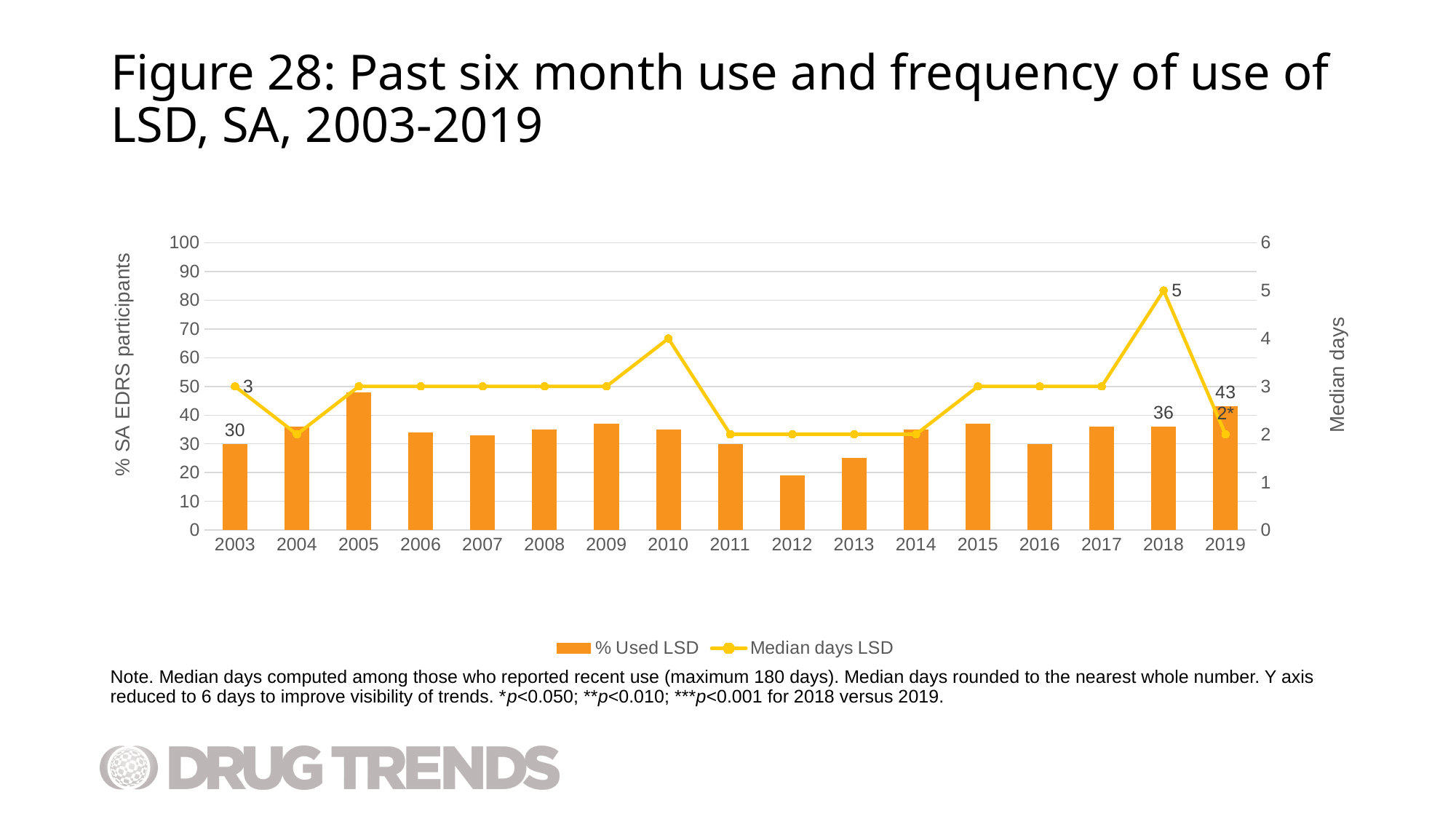
What is the value for Median days LSD in 2019? 2* What is the difference between the % Used LSD values for 2019 and 2018? 7 What is the value for % Used LSD in 2003? 30 How many series does the legend list? 2 Which year has the lowest % Used LSD bar? 2012 Which year has the highest Median days LSD value? 2018 Is the % Used LSD value for 2012 greater or less than 30? less What is the value for % Used LSD in 2019? 43 What is the value for Median days LSD in 2018? 5 What kind of chart is shown on the slide? Combined bar and line chart Which is larger, the % Used LSD value for 2018 or for 2019? 2019 How many years are shown on the x axis? 17